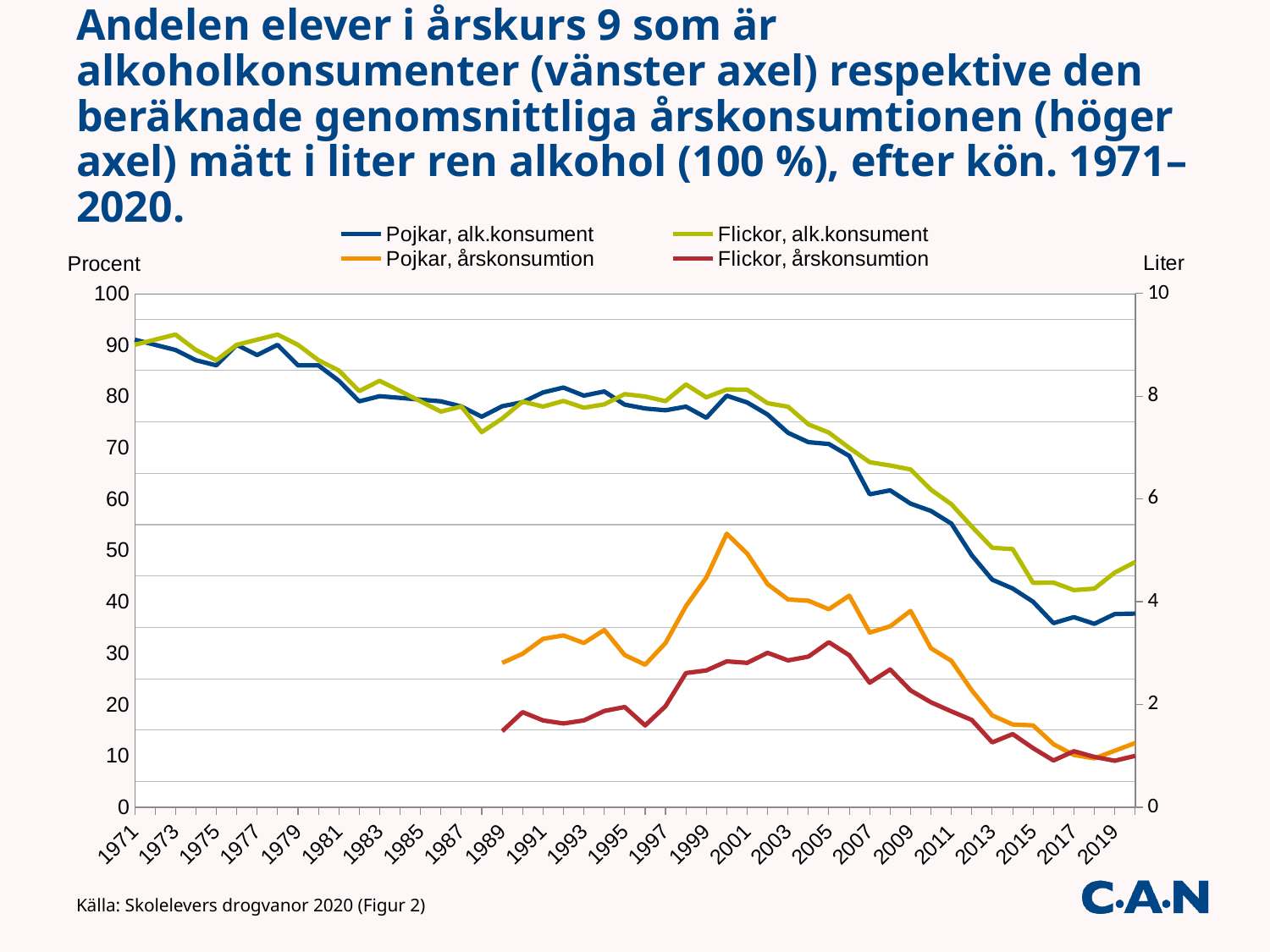
Is the value for 'Pojkar, årskonsumtion' at its peak around 2000 greater or less than 5 liters? greater What is the label of the left vertical axis? Procent What is the label of the right vertical axis? Liter Does the series 'Pojkar, alk.konsument' rise or fall overall from 1971 to 2020? fall In 2019, which is higher: 'Flickor, alk.konsument' or 'Pojkar, alk.konsument'? Flickor, alk.konsument How many series does the legend list? 4 What kind of chart is shown on the slide? line chart Is the value for 'Flickor, alk.konsument' in 2019 greater or less than 50? less Is the value for 'Pojkar, alk.konsument' in 1971 greater or less than 80? greater In 1989, which is higher: 'Pojkar, årskonsumtion' or 'Flickor, årskonsumtion'? Pojkar, årskonsumtion Which of the two årskonsumtion series reaches the highest value on the right axis? Pojkar, årskonsumtion